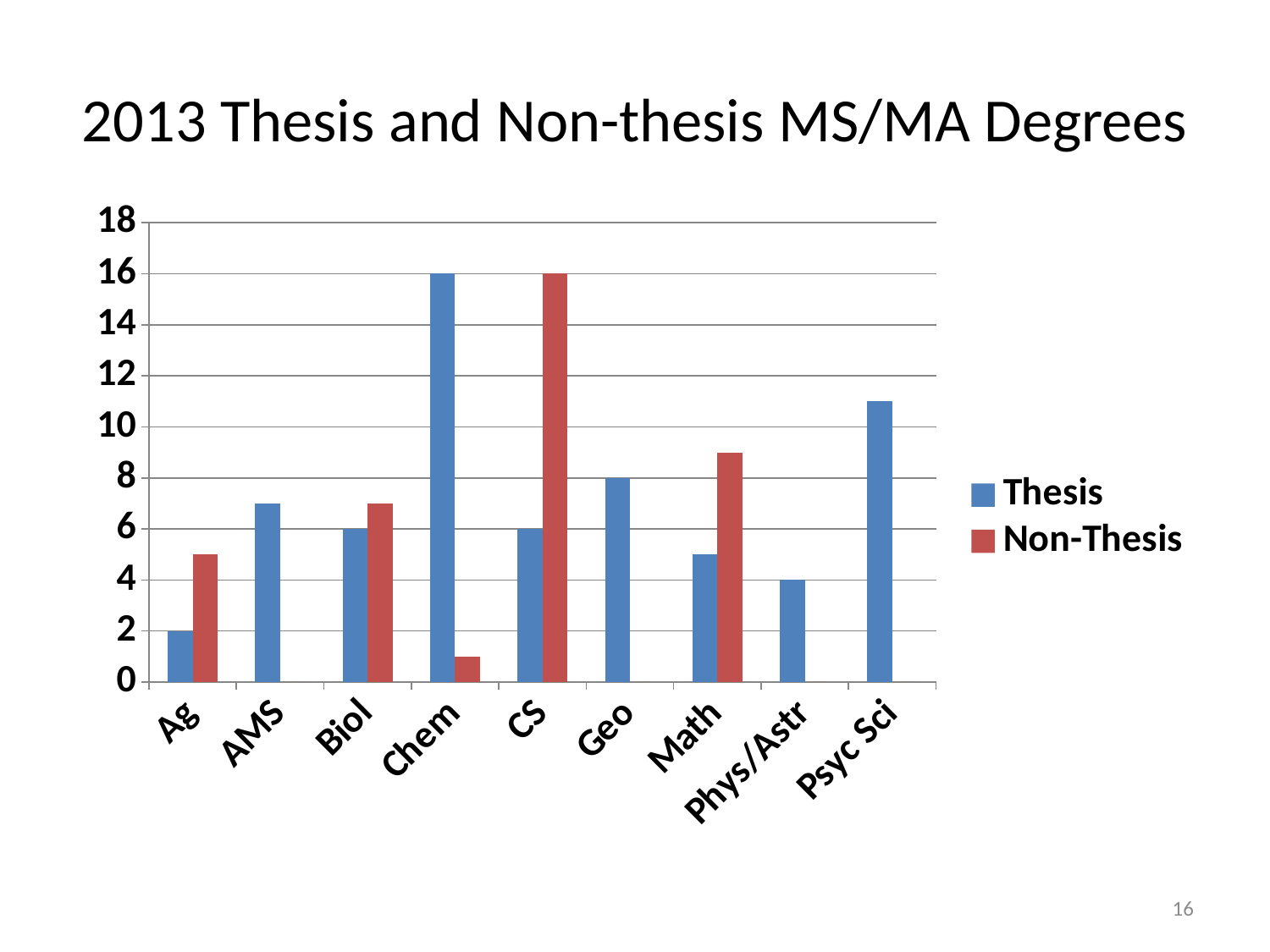
What is the Non-Thesis value for CS? 16 What kind of chart is shown on the slide? bar chart What is the Thesis value for Geo? 8 What is the difference between the Thesis values for Chem and Geo? 8 What is the Thesis value for Chem? 16 Which is larger for Biol, the Thesis value or the Non-Thesis value? Non-Thesis How many series does the legend list? 2 How many categories are shown on the x axis? 9 What is the Thesis value for Ag? 2 Is the Non-Thesis value for Math greater or less than 8? greater Which category has the lowest Thesis value? Ag Which category has the highest Thesis value? Chem